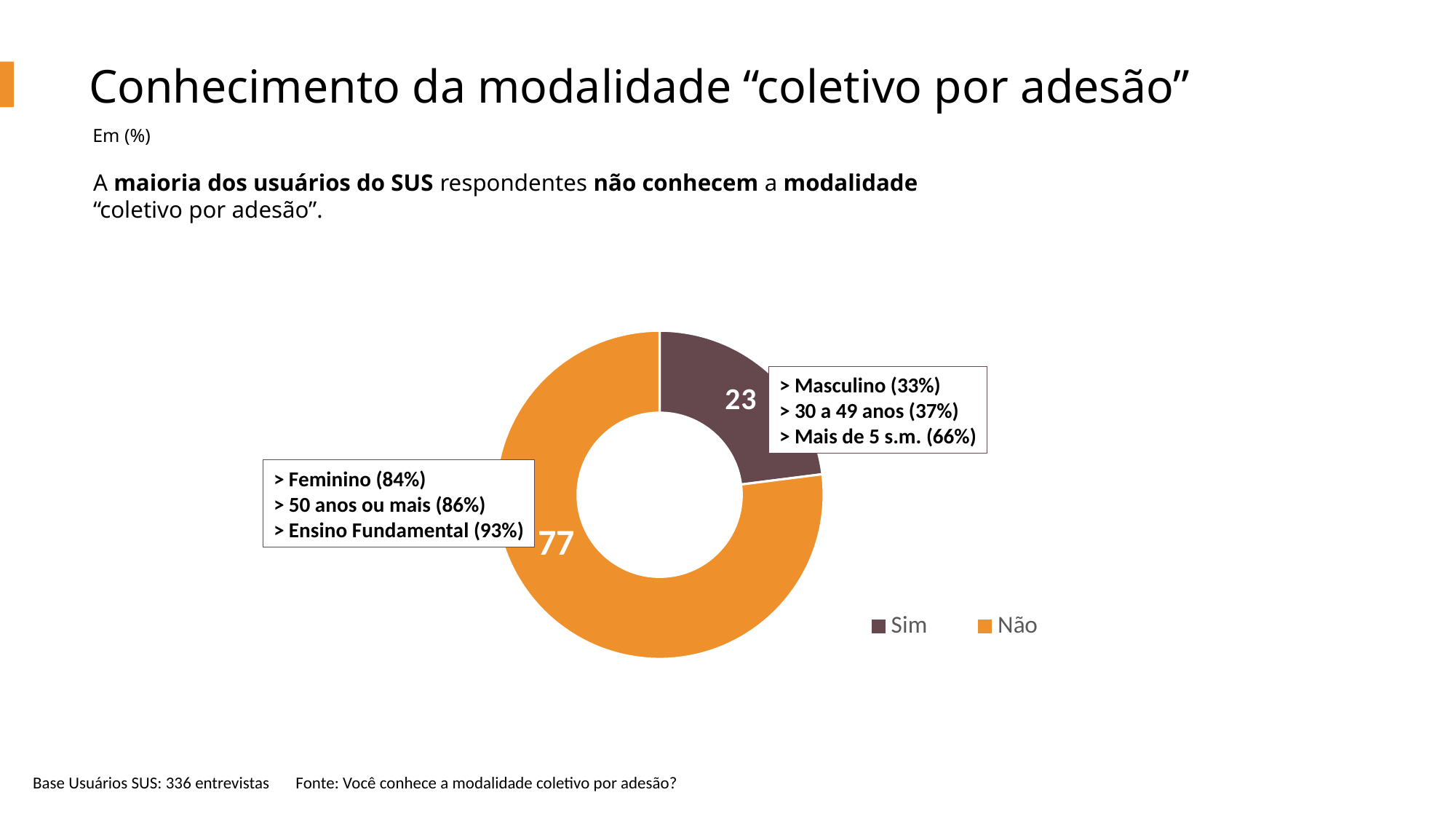
What share of the chart does the "Sim" slice represent? 23% How many slices does the chart have? 2 What value is shown for the "Não" slice? 77 How many entries does the legend list? 2 Which slice is the largest? Não What is the difference between the "Não" and "Sim" values? 54 Which slice is the smallest? Sim What kind of chart is shown on the slide? Doughnut (pie) chart What colour is the "Não" slice? Orange What value is shown for the "Sim" slice? 23 Which is larger, "Sim" or "Não"? Não What is the title of the slide containing the chart? Conhecimento da modalidade "coletivo por adesão"